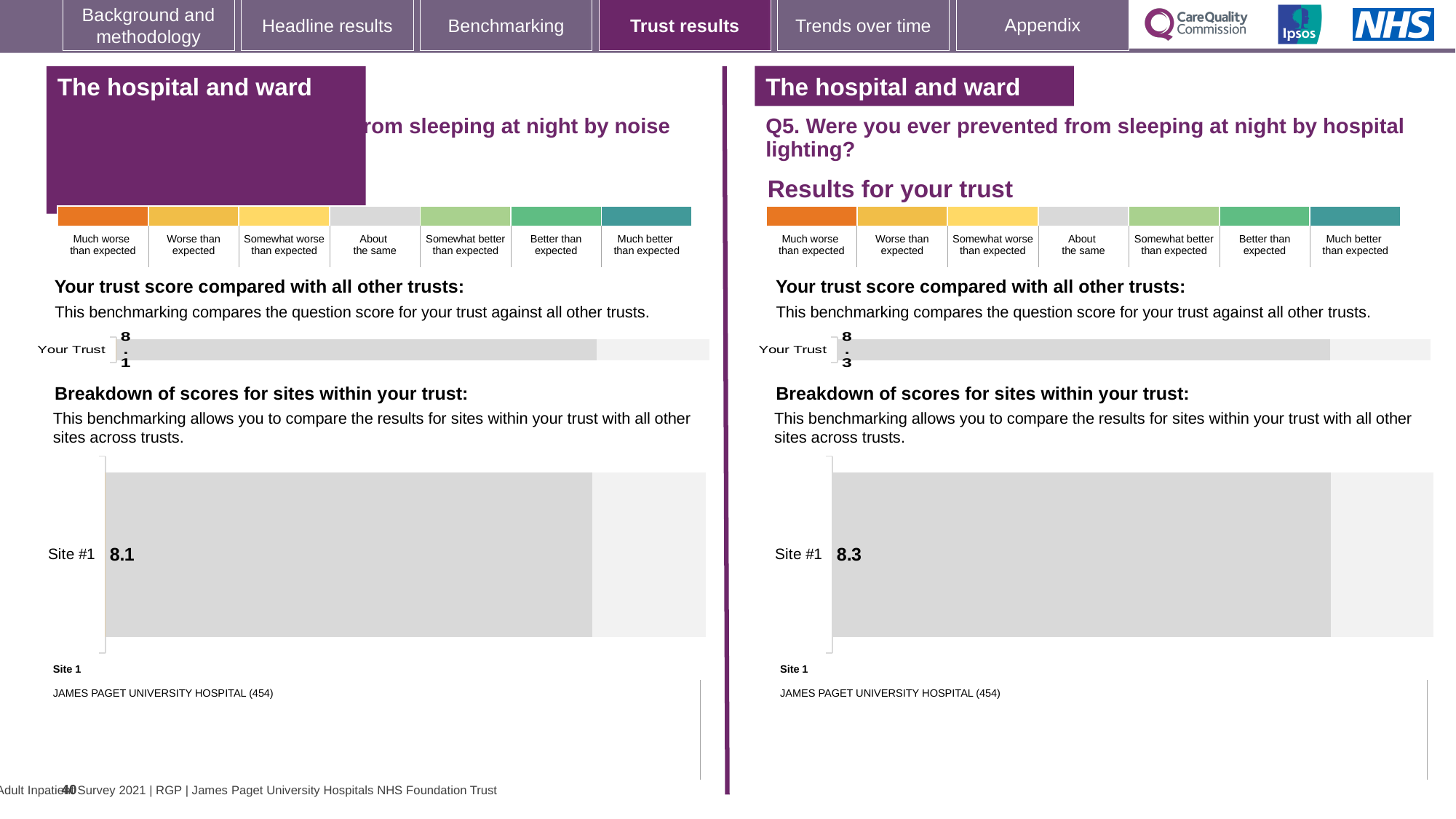
On the right half of the slide (Q5, hospital lighting), what is the score shown for Your Trust? 8.3 Which hospital is listed as Site 1 below the breakdown chart on the right half of the slide? JAMES PAGET UNIVERSITY HOSPITAL (454) On the left half of the slide (sleeping at night by noise), what score is shown for Site #1 in the breakdown chart? 8.1 How many sites are shown in the breakdown chart on the right half of the slide? 1 What is the question number of the hospital lighting question on the right half of the slide? Q5 How many rating categories are shown in the colour scale above the Q5 chart on the right half of the slide? 7 On the left half of the slide (sleeping at night by noise), what is the score shown for Your Trust? 8.1 What kind of chart is used to show the Site #1 score in the breakdown section on the right half of the slide? Bar chart On the right half of the slide (Q5, hospital lighting), what score is shown for Site #1 in the breakdown chart? 8.3 Which Site #1 score is higher: the one on the left half (noise) or the one on the right half (Q5, hospital lighting)? Right half (Q5, hospital lighting) What is the difference between the Site #1 score on the right half (8.3) and the Site #1 score on the left half (8.1)? 0.2